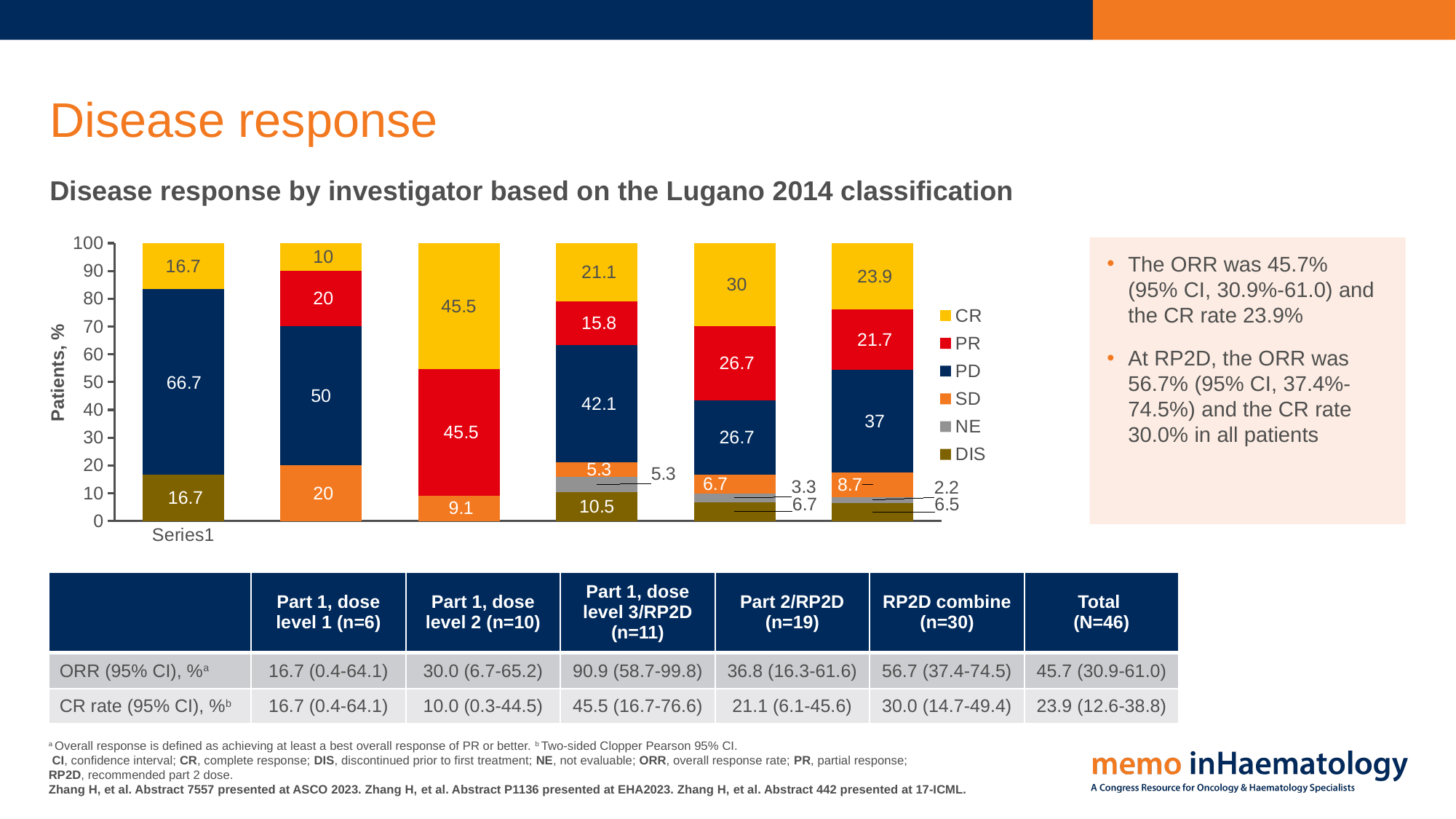
Which segment is the largest in the second bar from the left? PD In the fourth bar from the left, what is the difference between the CR value and the PR value? 5.3 How many stacked bars are plotted in the chart? 6 Which bar has the highest CR value? The third bar from the left What is the title of the chart's vertical axis? Patients, % What is the PD value in the first (leftmost) bar, labelled Series1? 66.7 What is the PR value in the sixth (rightmost) bar? 21.7 What is the CR value in the third bar from the left? 45.5 Is the CR value larger in the fifth bar or in the sixth bar? The fifth bar What kind of chart is shown on the slide? Stacked bar chart How many series does the chart legend list? 6 What is the NE value in the fifth bar from the left? 3.3